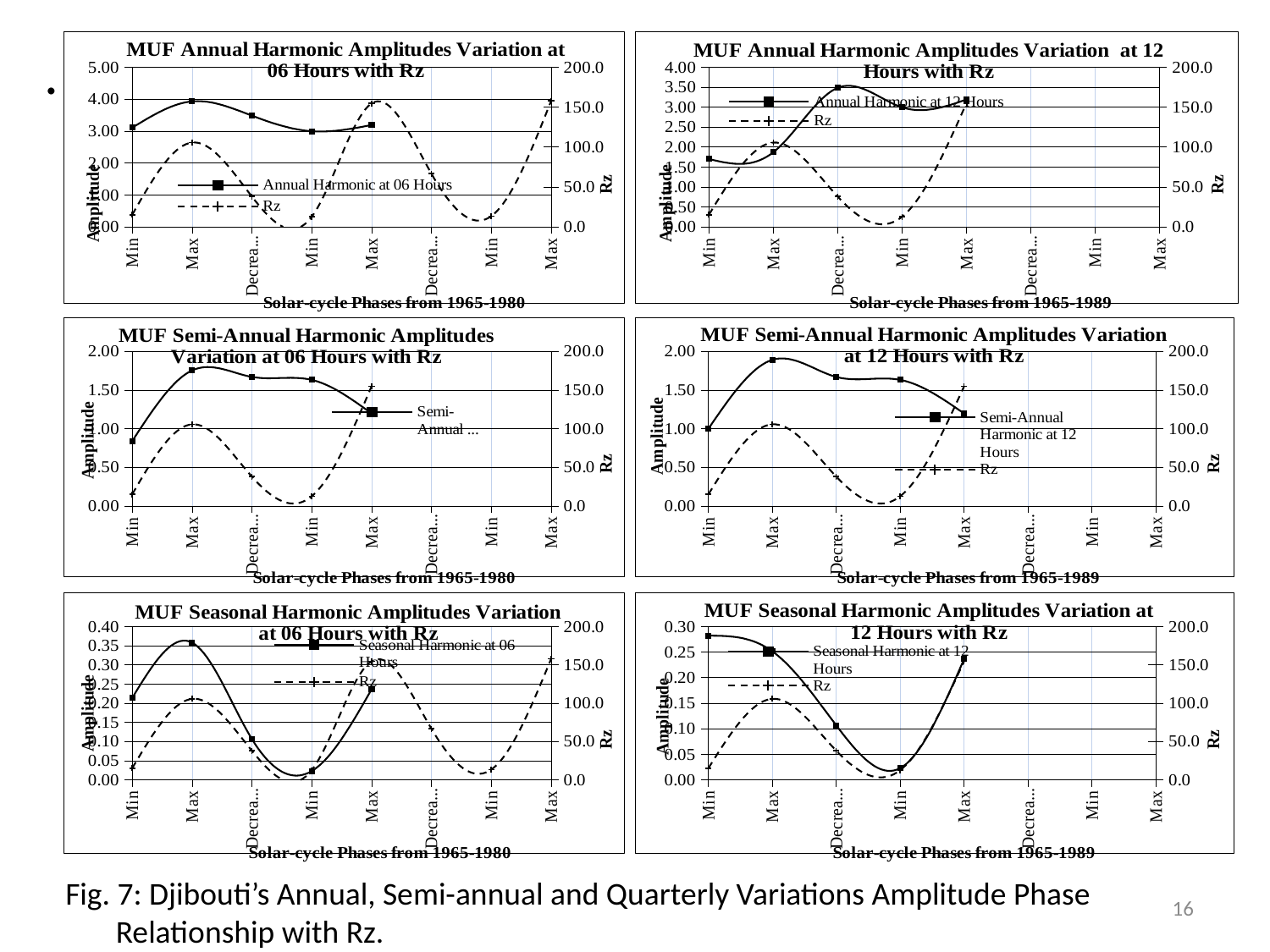
In the bottom-right chart (Seasonal Harmonic at 12 Hours), does the Seasonal Harmonic series rise or fall from the first 'Min' phase to the second 'Min' phase? fall In the middle-left chart (Semi-Annual Harmonic at 06 Hours), is the Semi-Annual Harmonic value at the first 'Min' phase greater or less than 1.00? less In the bottom-left chart (Seasonal Harmonic at 06 Hours), is the Seasonal Harmonic value at the first 'Max' phase greater or less than 0.30? greater In the top-left chart (Annual Harmonic at 06 Hours), how many solar-cycle phase categories are shown on the x axis? 8 What is the label of the right-hand vertical axis on the top-right chart (Annual Harmonic at 12 Hours)? Rz In the top-right chart (Annual Harmonic at 12 Hours), is the Annual Harmonic value at the first 'Decrea...' phase greater or less than 3.00? greater What is the x-axis title of the bottom-right chart (Seasonal Harmonic at 12 Hours)? Solar-cycle Phases from 1965-1989 In the middle-right chart (Semi-Annual Harmonic at 12 Hours), at which x-axis category does the Semi-Annual Harmonic series reach its highest value? Max (the first Max) What kind of chart is the top-left chart titled 'MUF Annual Harmonic Amplitudes Variation at 06 Hours with Rz'? line chart In the top-left chart (Annual Harmonic at 06 Hours), at which x-axis category does the Annual Harmonic series reach its highest value? Max (the first Max) In the bottom-right chart (Seasonal Harmonic at 12 Hours), at which x-axis category does the Seasonal Harmonic series reach its lowest value? Min (the second Min) In the top-left chart (Annual Harmonic at 06 Hours), how many series does the legend list? 2